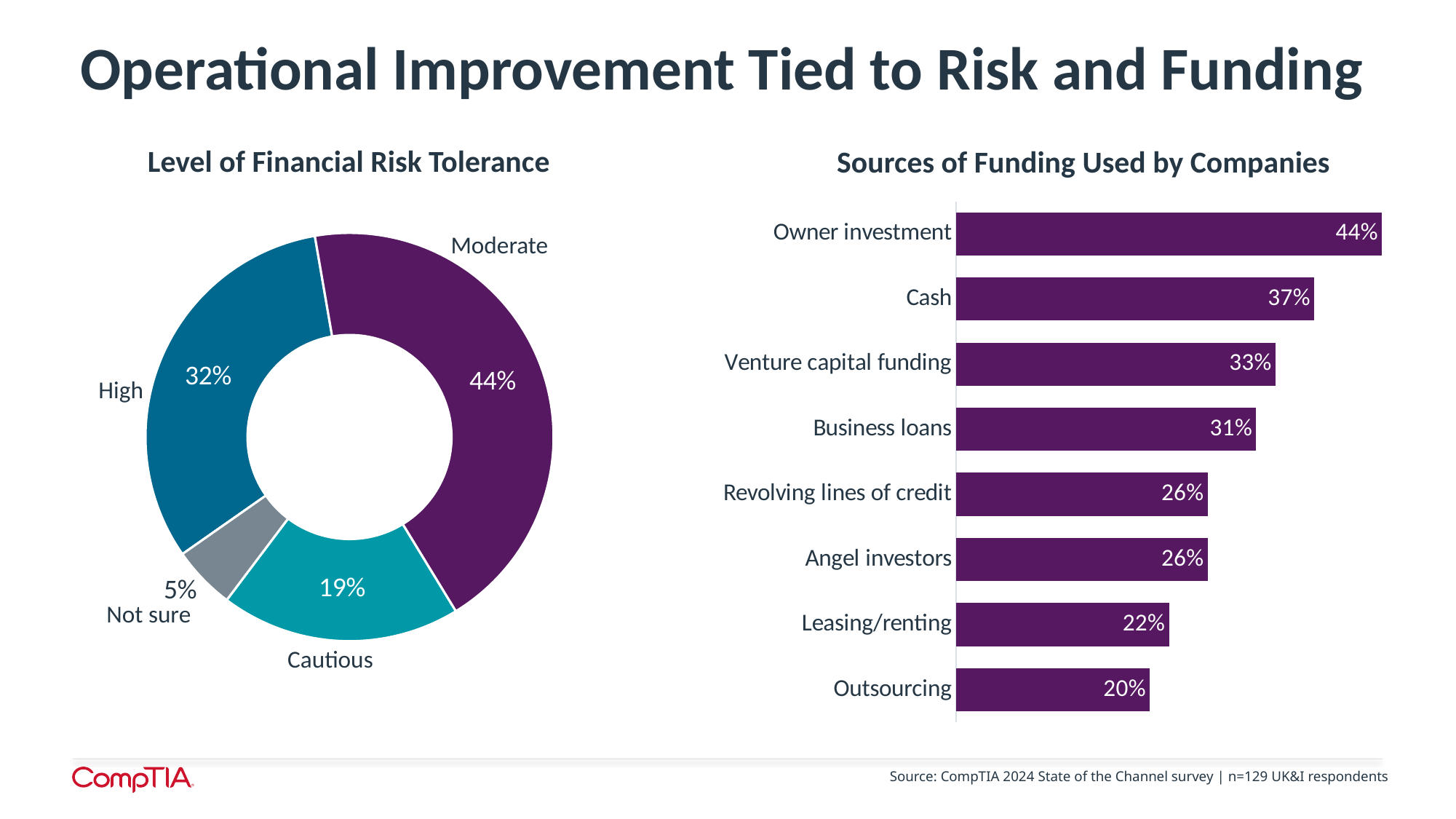
In the 'Level of Financial Risk Tolerance' chart, what share of respondents reported a Moderate risk tolerance? 44% In the 'Sources of Funding Used by Companies' chart, what is the difference between Cash and Leasing/renting? 15% In the 'Sources of Funding Used by Companies' chart, which funding source has the highest value? Owner investment In the 'Level of Financial Risk Tolerance' chart, which category has the smallest share? Not sure What kind of chart is 'Sources of Funding Used by Companies'? Bar chart What kind of chart is 'Level of Financial Risk Tolerance'? Doughnut chart In the 'Sources of Funding Used by Companies' chart, which funding source has the lowest value? Outsourcing In the 'Sources of Funding Used by Companies' chart, what percentage of companies used Business loans? 31% In the 'Level of Financial Risk Tolerance' chart, what is the difference between the High and Cautious shares? 13% In the 'Level of Financial Risk Tolerance' chart, how many categories are shown? 4 In the 'Sources of Funding Used by Companies' chart, which is larger: Venture capital funding or Revolving lines of credit? Venture capital funding In the 'Sources of Funding Used by Companies' chart, how many funding sources are listed? 8